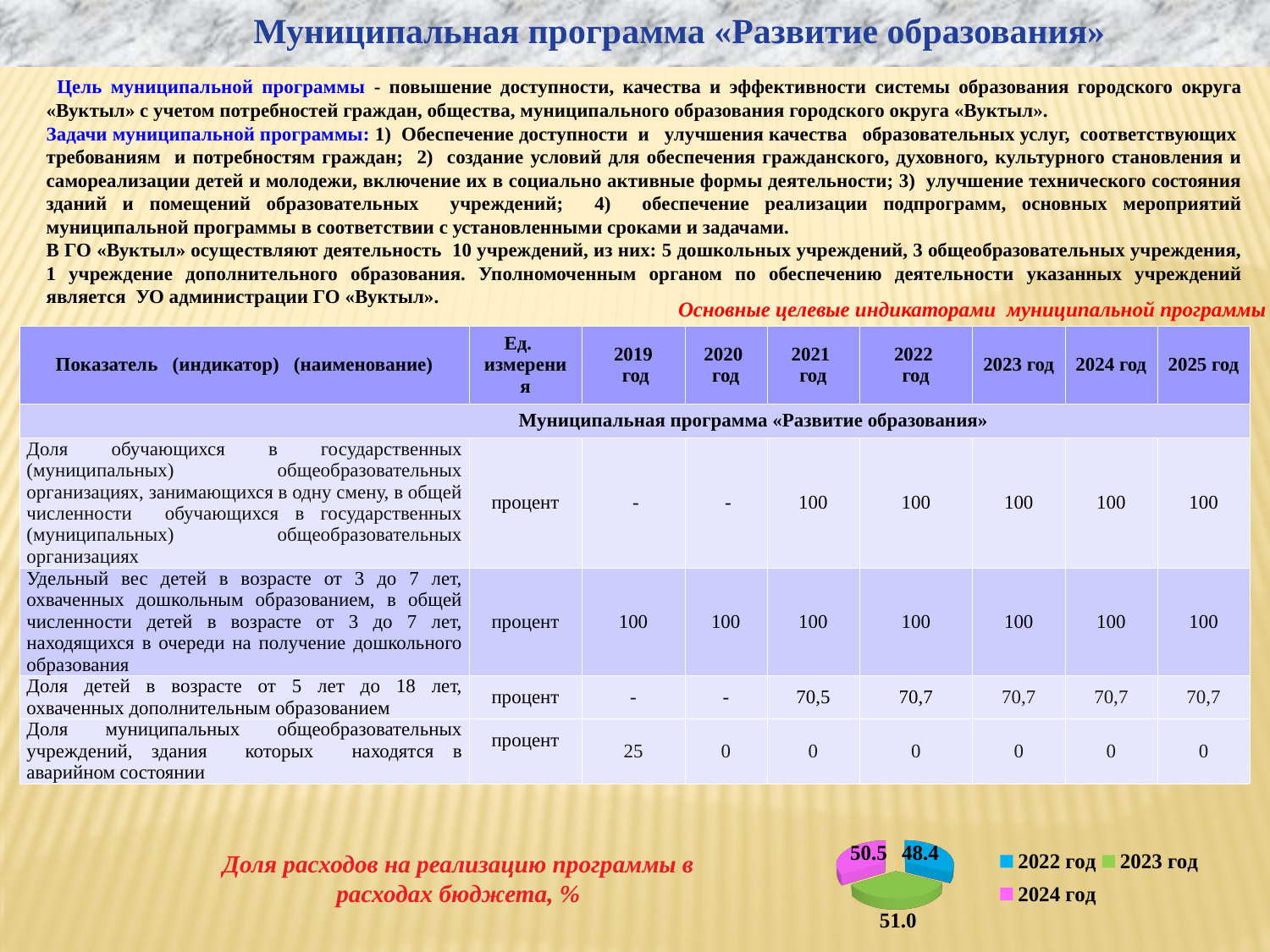
How many entries does the legend of the pie chart list? 3 How many slices does the pie chart have? 3 In the pie chart, what is the difference between the values for 2023 год and 2024 год? 0.5 Which year has the lowest value in the pie chart? 2022 год In the pie chart, what value is shown for 2022 год? 48.4 In the pie chart, which is larger: the value for 2022 год or the value for 2024 год? 2024 год What is the title of the pie chart on the slide? Доля расходов на реализацию программы в расходах бюджета, % In the pie chart, what value is shown for 2023 год? 51.0 What kind of chart is shown at the bottom of the slide? pie chart Which years are listed in the legend of the pie chart? 2022 год, 2023 год, 2024 год Which year has the highest value in the pie chart? 2023 год In the pie chart, what value is shown for 2024 год? 50.5